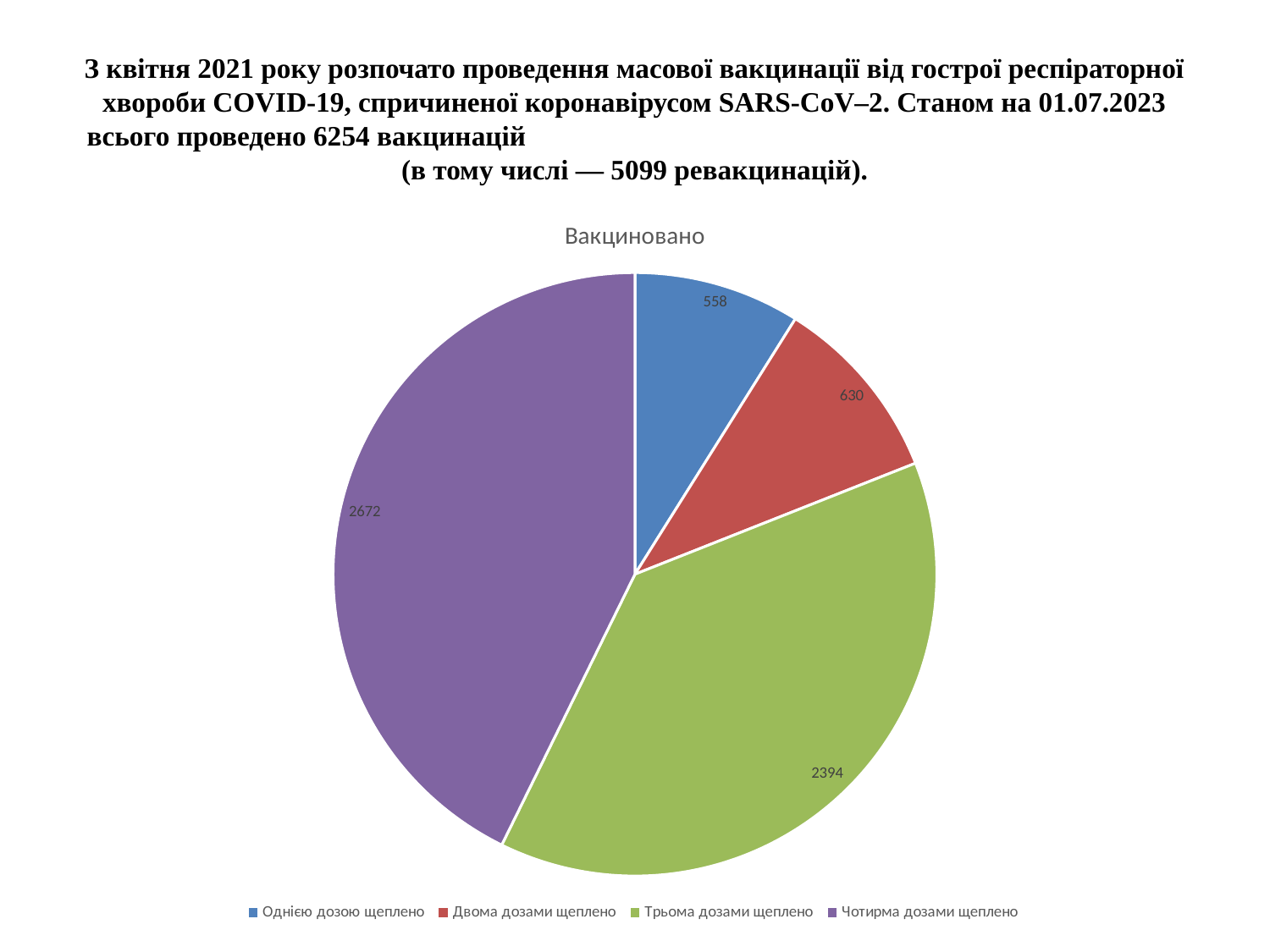
What is the value for "Двома дозами щеплено"? 630 What is the value for "Однією дозою щеплено"? 558 What is the difference between the values for "Чотирма дозами щеплено" and "Трьома дозами щеплено"? 278 What colour is the slice for "Трьома дозами щеплено"? Green Which category has the smallest slice of the pie? Однією дозою щеплено Which category has the largest slice of the pie? Чотирма дозами щеплено What type of chart is shown on the slide? Pie chart What is the value for "Чотирма дозами щеплено"? 2672 What is the value for "Трьома дозами щеплено"? 2394 How many slices does the pie chart have? 4 What is the title of the chart? Вакциновано Which is larger: the value for "Двома дозами щеплено" or "Однією дозою щеплено"? Двома дозами щеплено